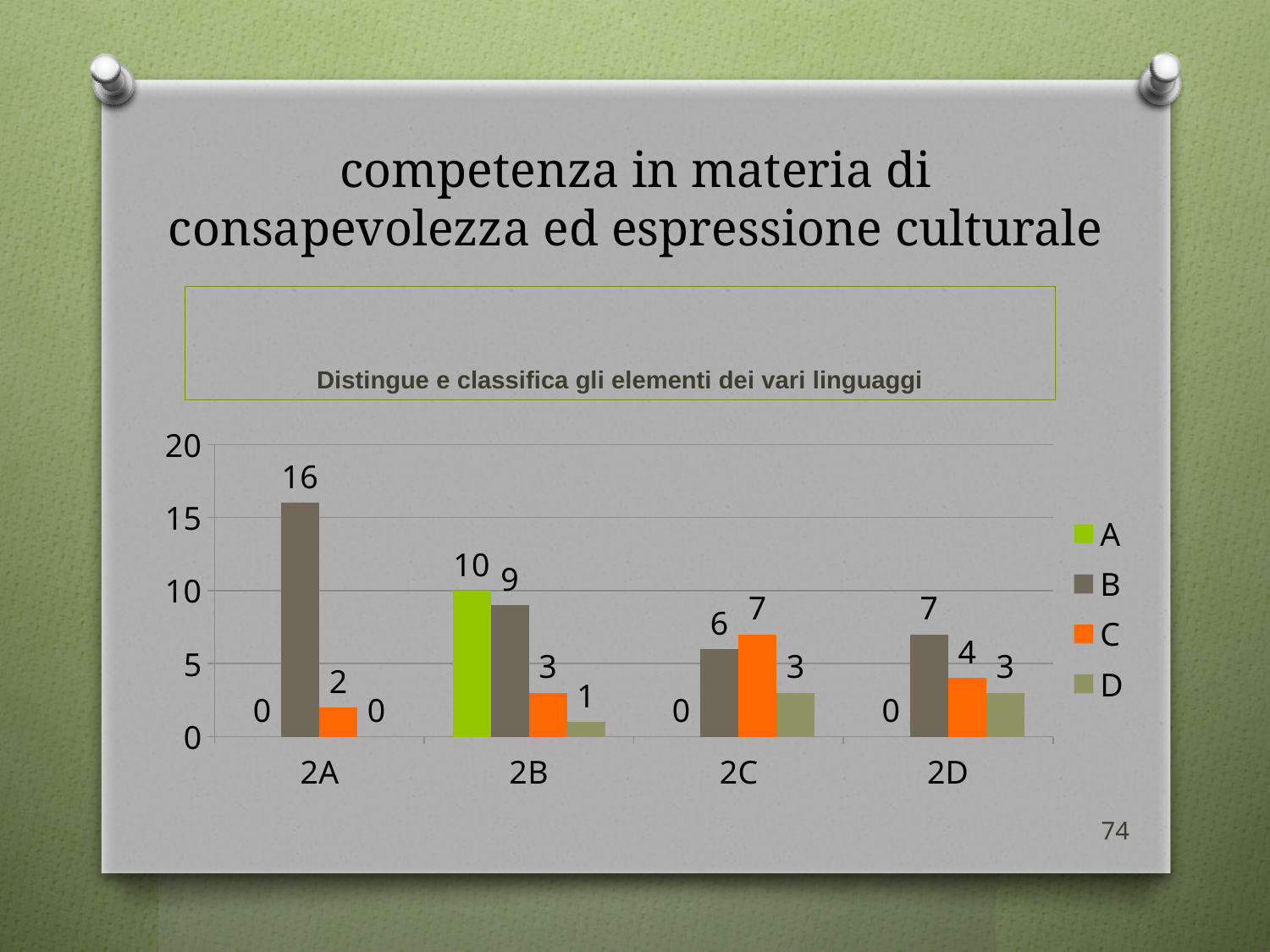
How many series does the legend list? 4 What kind of chart is shown on the slide? bar chart Which category has the lowest value for series C? 2A What is the value of series C for category 2C? 7 What is the title of the chart? Distingue e classifica gli elementi dei vari linguaggi How many categories are shown on the x axis? 4 What is the value of series B for category 2A? 16 What is the value of series A for category 2B? 10 What is the value of series D for category 2D? 3 For category 2C, which is larger: series B or series C? C What is the difference between the series B value for 2A and the series B value for 2B? 7 Which category has the highest value for series B? 2A